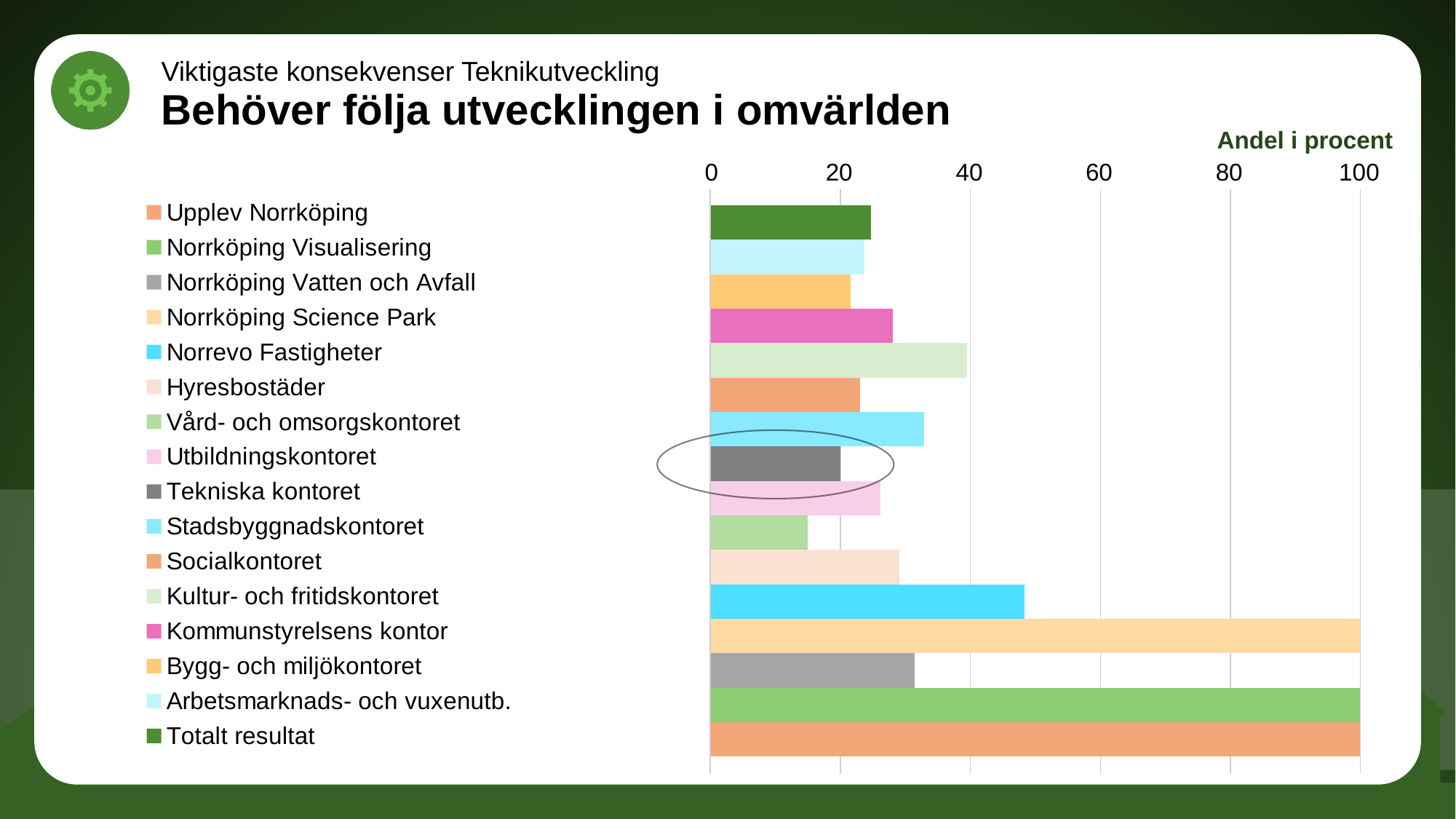
How many categories are plotted in the chart? 16 Is the value for Norrevo Fastigheter greater or less than 40? greater Which category has the lowest value? Vård- och omsorgskontoret Is the value for Vård- och omsorgskontoret greater or less than 20? less How many entries does the legend list? 16 What kind of chart is shown on the slide? bar chart What is the value for Norrköping Science Park? 100 Is the value for Stadsbyggnadskontoret greater or less than 40? less Which is larger, the value for Kultur- och fritidskontoret or the value for Socialkontoret? Kultur- och fritidskontoret Which is larger, the value for Norrevo Fastigheter or the value for Stadsbyggnadskontoret? Norrevo Fastigheter What is the label shown above the horizontal axis of the chart? Andel i procent What is the value for Upplev Norrköping? 100